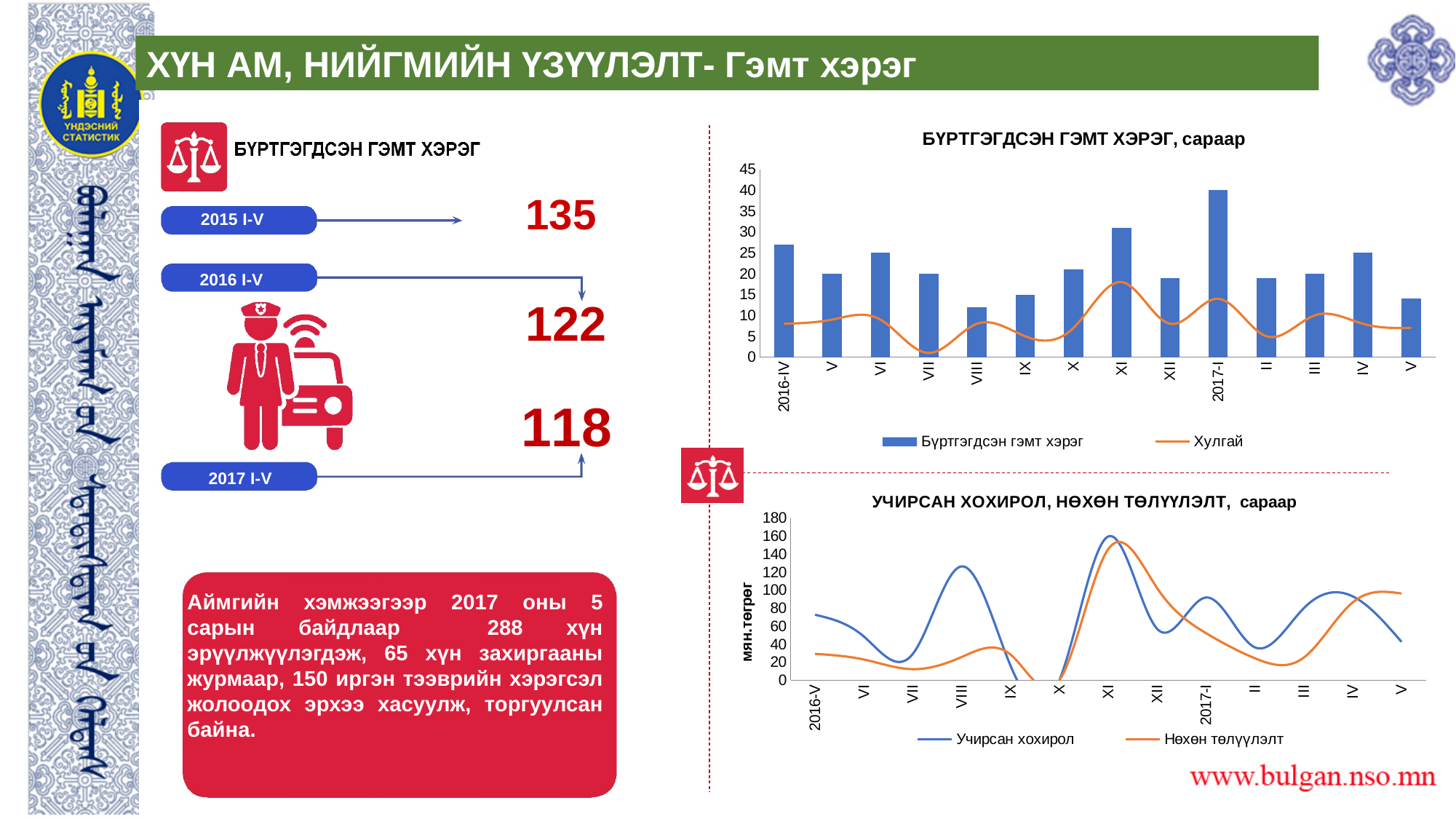
In the chart titled 'БҮРТГЭГДСЭН ГЭМТ ХЭРЭГ, сараар', what is the value of the bar for 2017-I? 40 What kind of chart is 'УЧИРСАН ХОХИРОЛ, НӨХӨН ТӨЛҮҮЛЭЛТ, сараар'? line chart In the chart titled 'БҮРТГЭГДСЭН ГЭМТ ХЭРЭГ, сараар', is the bar for XI (2016) greater or less than 25? greater In the chart titled 'БҮРТГЭГДСЭН ГЭМТ ХЭРЭГ, сараар', how many months are shown on the x axis? 14 In the chart titled 'БҮРТГЭГДСЭН ГЭМТ ХЭРЭГ, сараар', which month has the highest bar? 2017-I In the chart titled 'БҮРТГЭГДСЭН ГЭМТ ХЭРЭГ, сараар', which is larger: the bar for VI (2016) or the bar for VIII (2016)? VI In the chart titled 'БҮРТГЭГДСЭН ГЭМТ ХЭРЭГ, сараар', how many series does the legend list? 2 In the chart titled 'БҮРТГЭГДСЭН ГЭМТ ХЭРЭГ, сараар', which month has the lowest bar? VIII In the chart titled 'БҮРТГЭГДСЭН ГЭМТ ХЭРЭГ, сараар', what is the difference between the bars for 2017-I and 2017-III? 20 In the chart titled 'БҮРТГЭГДСЭН ГЭМТ ХЭРЭГ, сараар', what is the value of the bar for IX (2016)? 15 In the chart titled 'УЧИРСАН ХОХИРОЛ, НӨХӨН ТӨЛҮҮЛЭЛТ, сараар', in which month does 'Учирсан хохирол' reach its highest value? XI In the chart titled 'УЧИРСАН ХОХИРОЛ, НӨХӨН ТӨЛҮҮЛЭЛТ, сараар', what unit is shown on the y axis label? мян.төгрөг